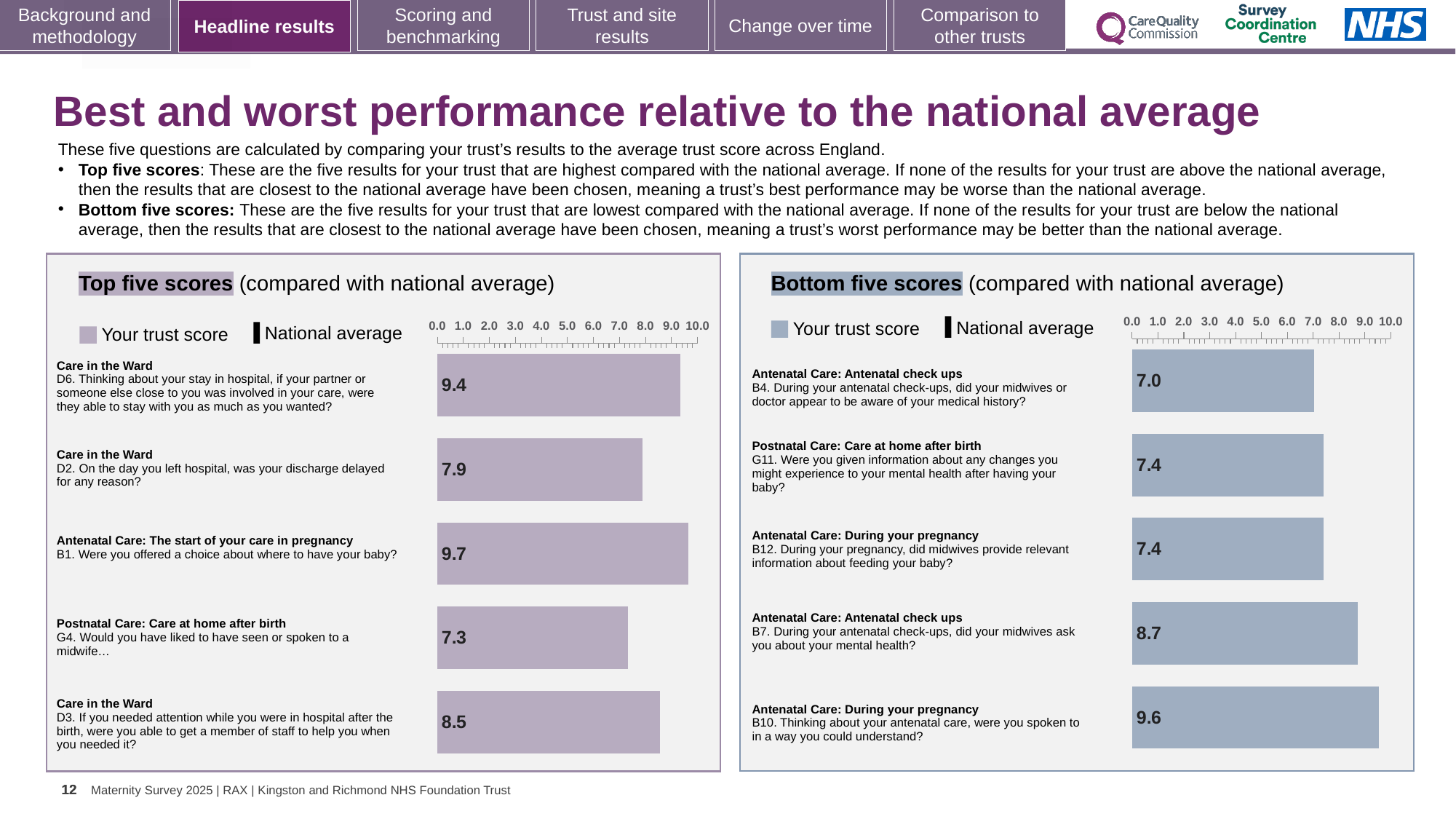
What kind of chart is the Bottom five scores chart? Bar chart On the Bottom five scores chart, what is the trust score for B10 (spoken to in a way you could understand)? 9.6 How many entries does the legend of the Top five scores chart list? 2 On the Top five scores chart, which question has the highest trust score? B1. Were you offered a choice about where to have your baby? How many bars are plotted on the Top five scores chart? 5 On the Top five scores chart, what is the trust score for D6 (partner or someone close able to stay with you as much as you wanted)? 9.4 On the Top five scores chart, which question has the lowest trust score? G4. Would you have liked to have seen or spoken to a midwife… On the Bottom five scores chart, which question has the lowest trust score? B4. During your antenatal check-ups, did your midwives or doctor appear to be aware of your medical history? On the Top five scores chart, what is the difference between the trust scores for B1 and G4? 2.4 On the Bottom five scores chart, which has the larger trust score: B7 or G11? B7 On the Bottom five scores chart, what is the difference between the trust scores for B10 and B4? 2.6 On the Bottom five scores chart, which question has the highest trust score? B10. Thinking about your antenatal care, were you spoken to in a way you could understand?